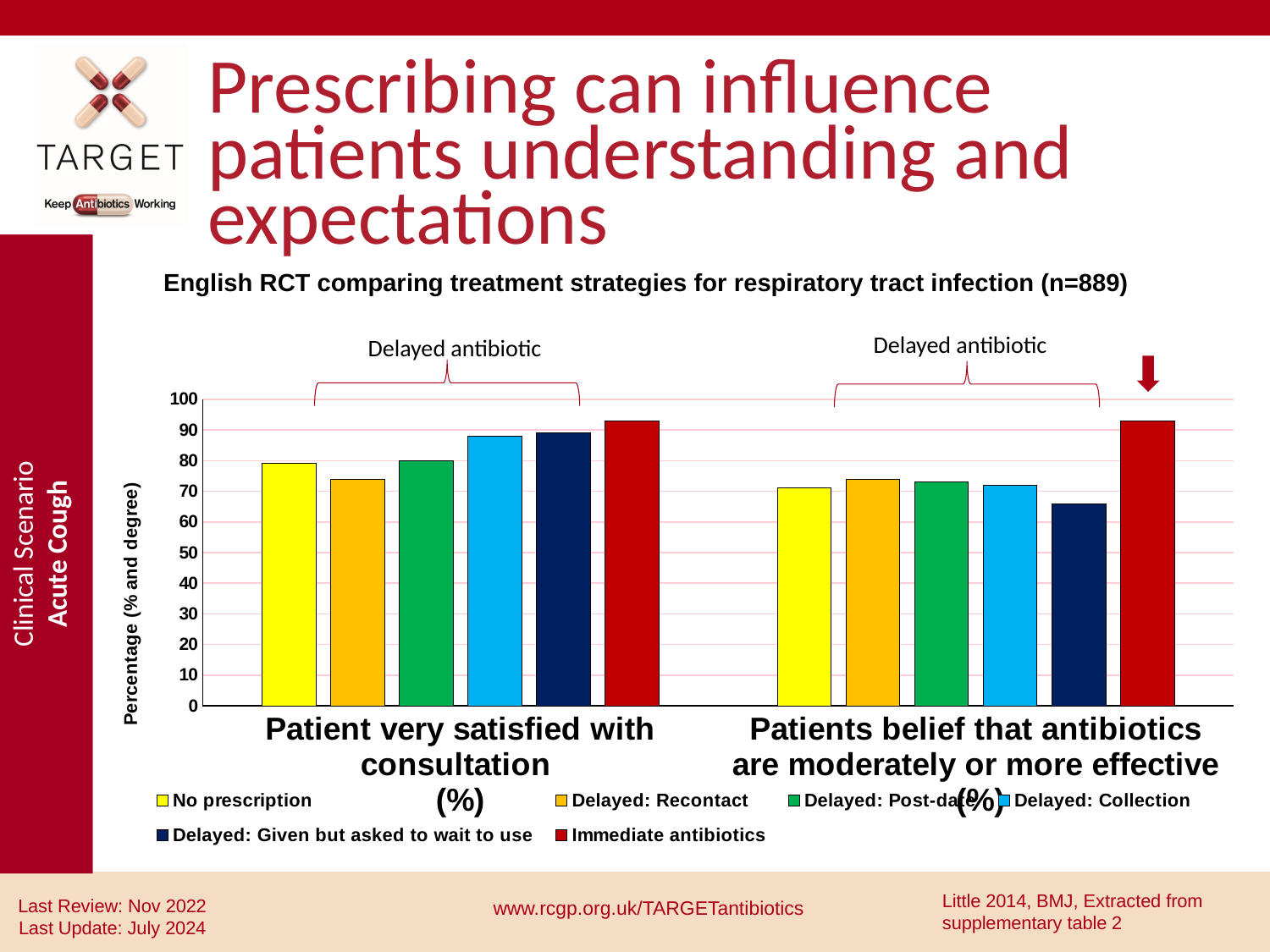
Which series has the lowest value for 'Patient very satisfied with consultation (%)'? Delayed: Recontact For 'Patient very satisfied with consultation (%)', which is larger: 'Delayed: Collection' or 'Delayed: Recontact'? Delayed: Collection Is the value for 'Immediate antibiotics' in 'Patients belief that antibiotics are moderately or more effective (%)' greater or less than 90? greater How many series does the legend list? 6 Is the value for 'Delayed: Given but asked to wait to use' in 'Patients belief that antibiotics are moderately or more effective (%)' greater or less than 70? less What kind of chart is shown on the slide? Bar chart Which series has the highest value for 'Patient very satisfied with consultation (%)'? Immediate antibiotics Which series has the lowest value for 'Patients belief that antibiotics are moderately or more effective (%)'? Delayed: Given but asked to wait to use Which series has the highest value for 'Patients belief that antibiotics are moderately or more effective (%)'? Immediate antibiotics Is the value for 'No prescription' in 'Patient very satisfied with consultation (%)' greater or less than 70? greater What is the title of the y axis? Percentage (% and degree) How many categories are shown on the x axis? 2